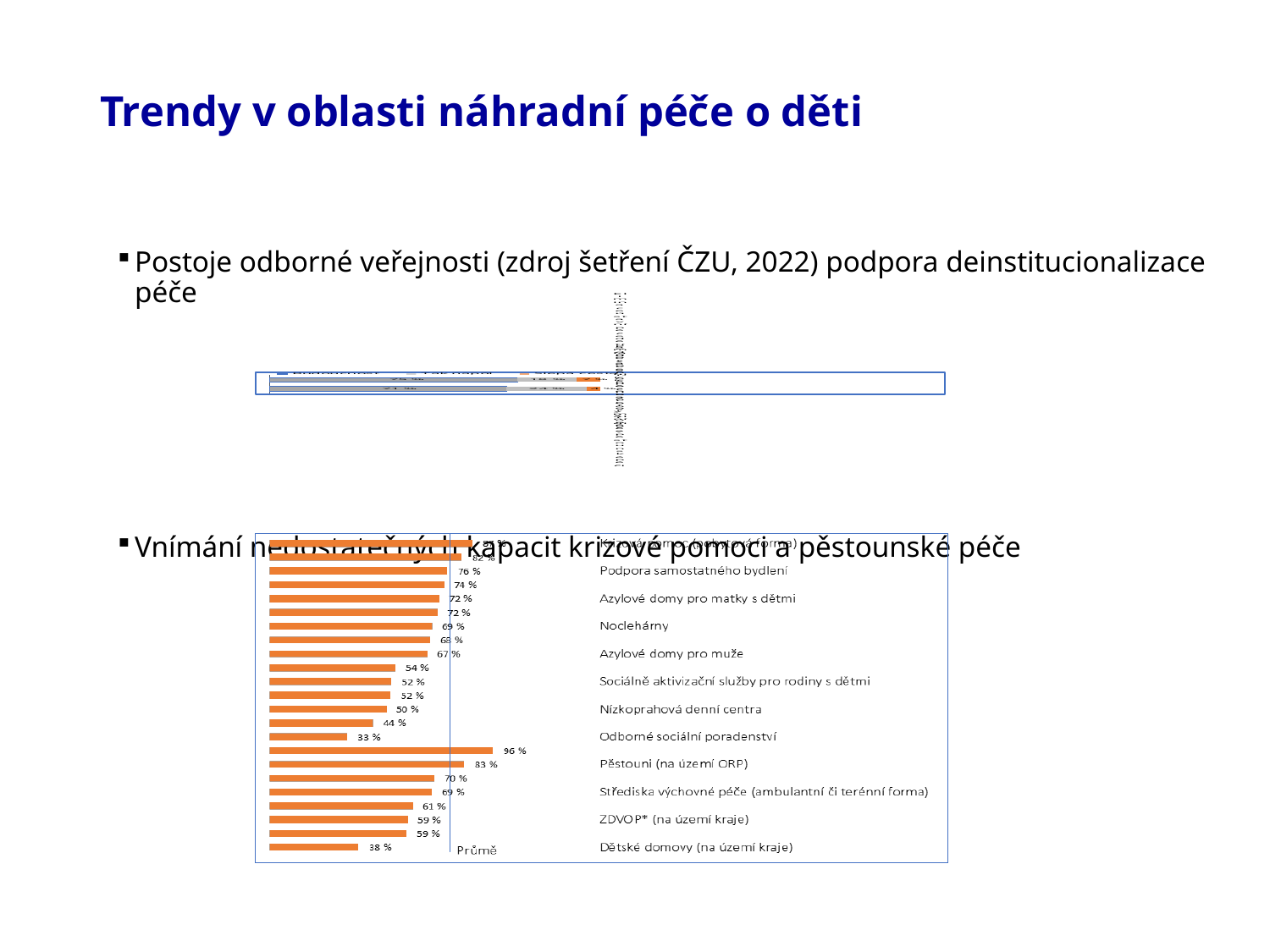
In the lower bar chart, which is larger: the bar labelled 96 % or the bar labelled 83 %? 96 % In the lower bar chart, what is the difference between the largest printed value (96 %) and the smallest printed value (33 %)? 63 % In the lower bar chart, what is the smallest value printed on any bar? 33 % What text label appears at the bottom of the vertical line in the lower bar chart? Průmě What kind of chart is the lower chart on the slide? bar chart In the lower bar chart, how many bars carry the data label 59 %? 2 In the lower bar chart, how many bars carry the data label 52 %? 2 In the lower bar chart, how many bars carry the data label 72 %? 2 In the lower bar chart, what is the largest value printed on any bar? 96 % What colour are the bars in the lower bar chart? orange